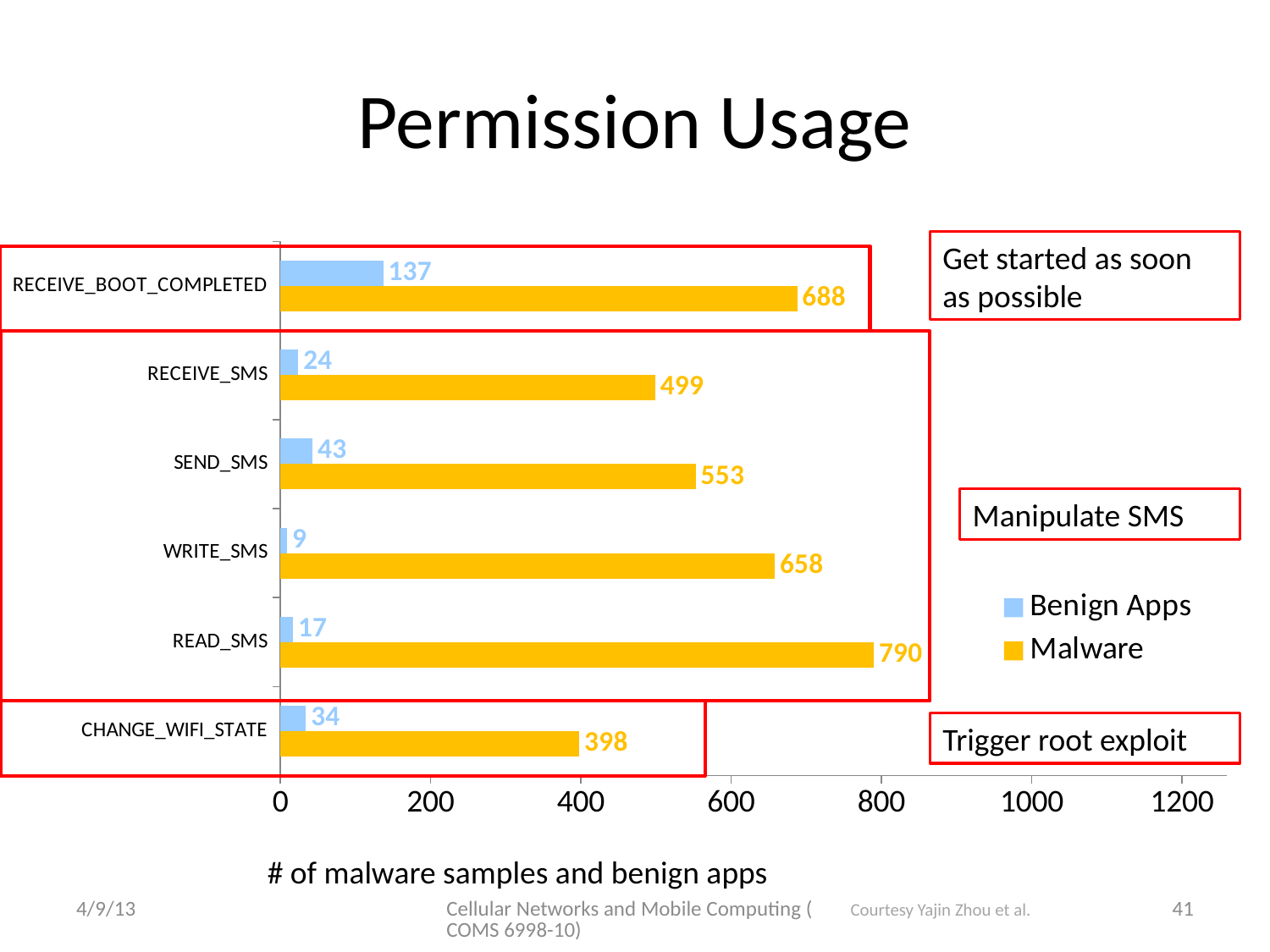
What is the x-axis label of the chart? # of malware samples and benign apps Which permission has the lowest Benign Apps value? WRITE_SMS How many permissions are shown on the chart? 6 Is the Malware value for RECEIVE_BOOT_COMPLETED greater or less than 600? greater How many series does the legend list? 2 What is the difference between the Malware and Benign Apps values for WRITE_SMS? 649 What is the Malware value for READ_SMS? 790 What is the Benign Apps value for RECEIVE_BOOT_COMPLETED? 137 What is the Malware value for CHANGE_WIFI_STATE? 398 Which permission has the highest Malware value? READ_SMS Which is larger, the Malware value for SEND_SMS or the Malware value for RECEIVE_SMS? SEND_SMS What kind of chart is shown on the slide? bar chart